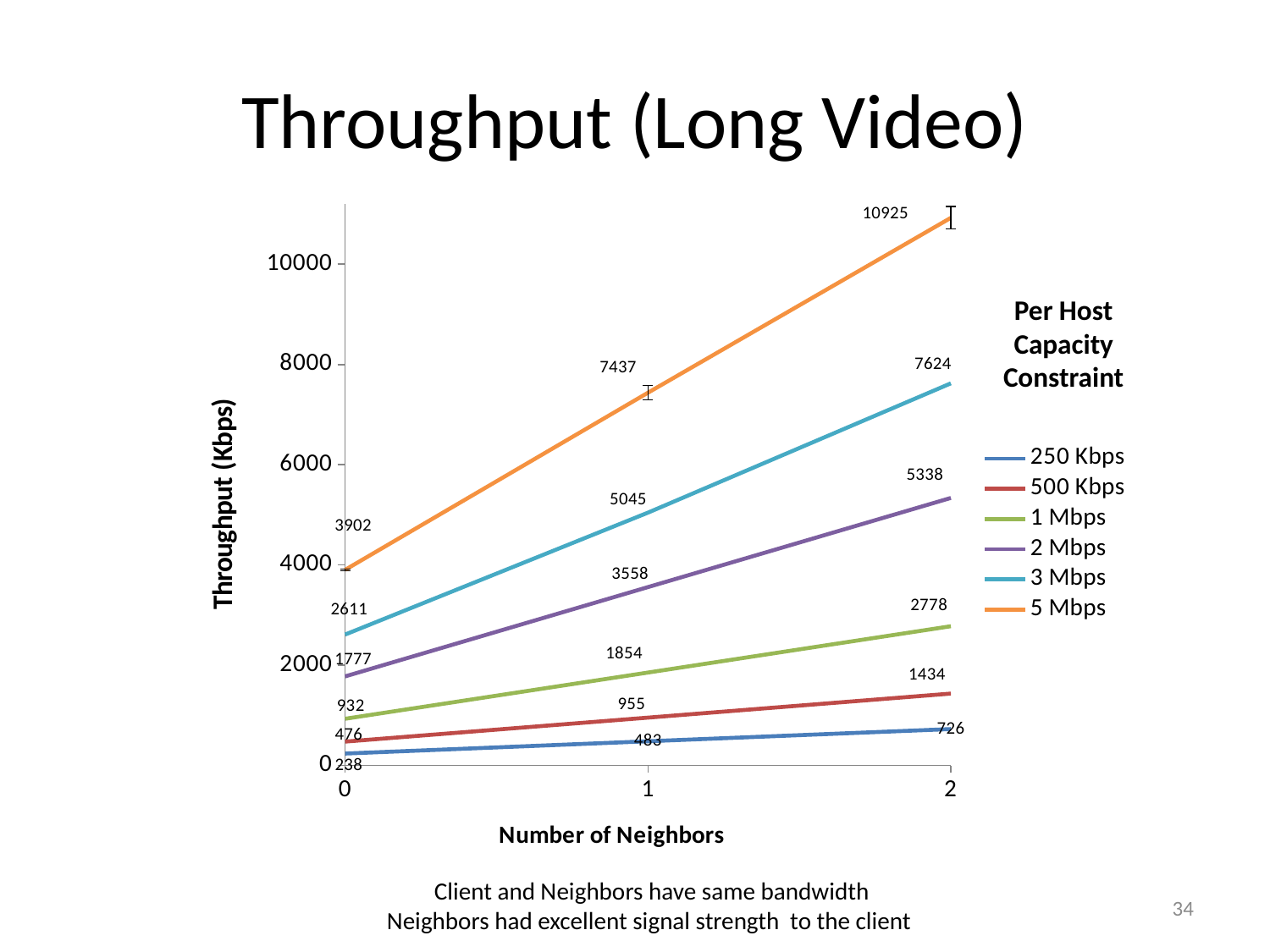
What is the throughput for the 1 Mbps series at 2 neighbors? 2778 What is the throughput for the 5 Mbps series at 2 neighbors? 10925 What is the title of the x axis? Number of Neighbors Which series has the lowest throughput at 1 neighbor? 250 Kbps How many series does the legend list? 6 Which series has the highest throughput at 2 neighbors? 5 Mbps What is the throughput for the 250 Kbps series at 0 neighbors? 238 What is the throughput for the 3 Mbps series at 1 neighbor? 5045 What type of chart is shown on the slide? line chart Does the throughput for the 500 Kbps series rise or fall as the number of neighbors increases? rise Which is larger: the 2 Mbps throughput at 1 neighbor or the 3 Mbps throughput at 0 neighbors? 2 Mbps at 1 neighbor What is the difference between the 5 Mbps throughput at 2 neighbors and at 0 neighbors? 7023